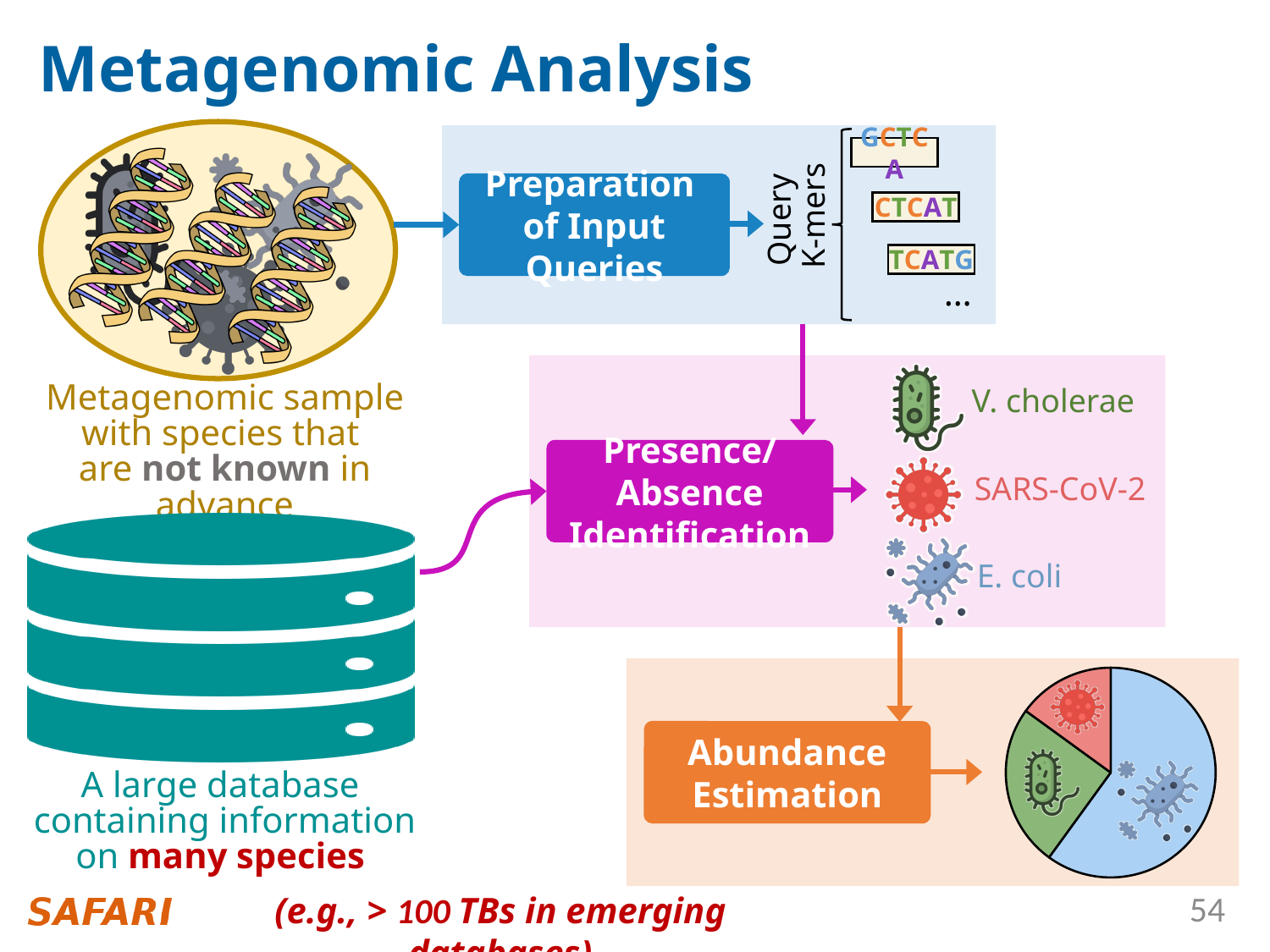
In the pie chart in the Abundance Estimation box, is the blue slice larger or smaller than the green slice? larger In the pie chart in the Abundance Estimation box, which colour slice is the largest? blue In the pie chart in the Abundance Estimation box, is the green slice larger or smaller than the red slice? larger Which species icon appears in the smallest (red) slice of the pie chart in the Abundance Estimation box? SARS-CoV-2 In the pie chart in the Abundance Estimation box, which colour slice is the smallest? red Which species icon appears in the largest (blue) slice of the pie chart in the Abundance Estimation box? E. coli What kind of chart is shown in the Abundance Estimation box at the bottom right of the slide? pie chart How many slices does the pie chart in the Abundance Estimation box have? 3 In the pie chart in the Abundance Estimation box, does the blue slice take up more or less than half of the pie? more